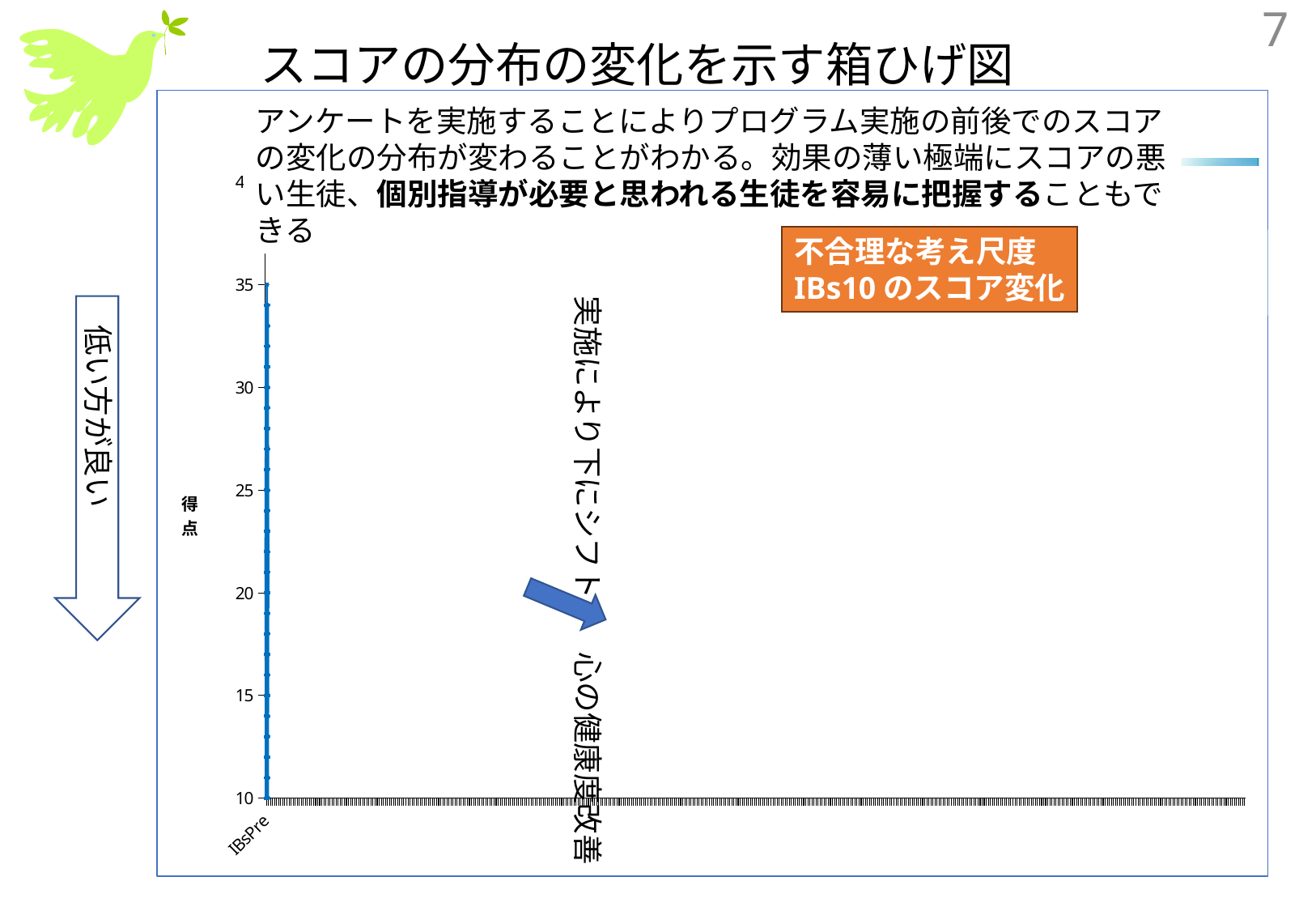
What is the label on the vertical axis of the chart? 得点 What category label is shown on the horizontal axis of the chart? IBsPre What is the highest tick value shown on the vertical axis of the chart? 35 How many category labels are shown on the horizontal axis of the chart? 1 What is the lowest tick value shown on the vertical axis of the chart? 10